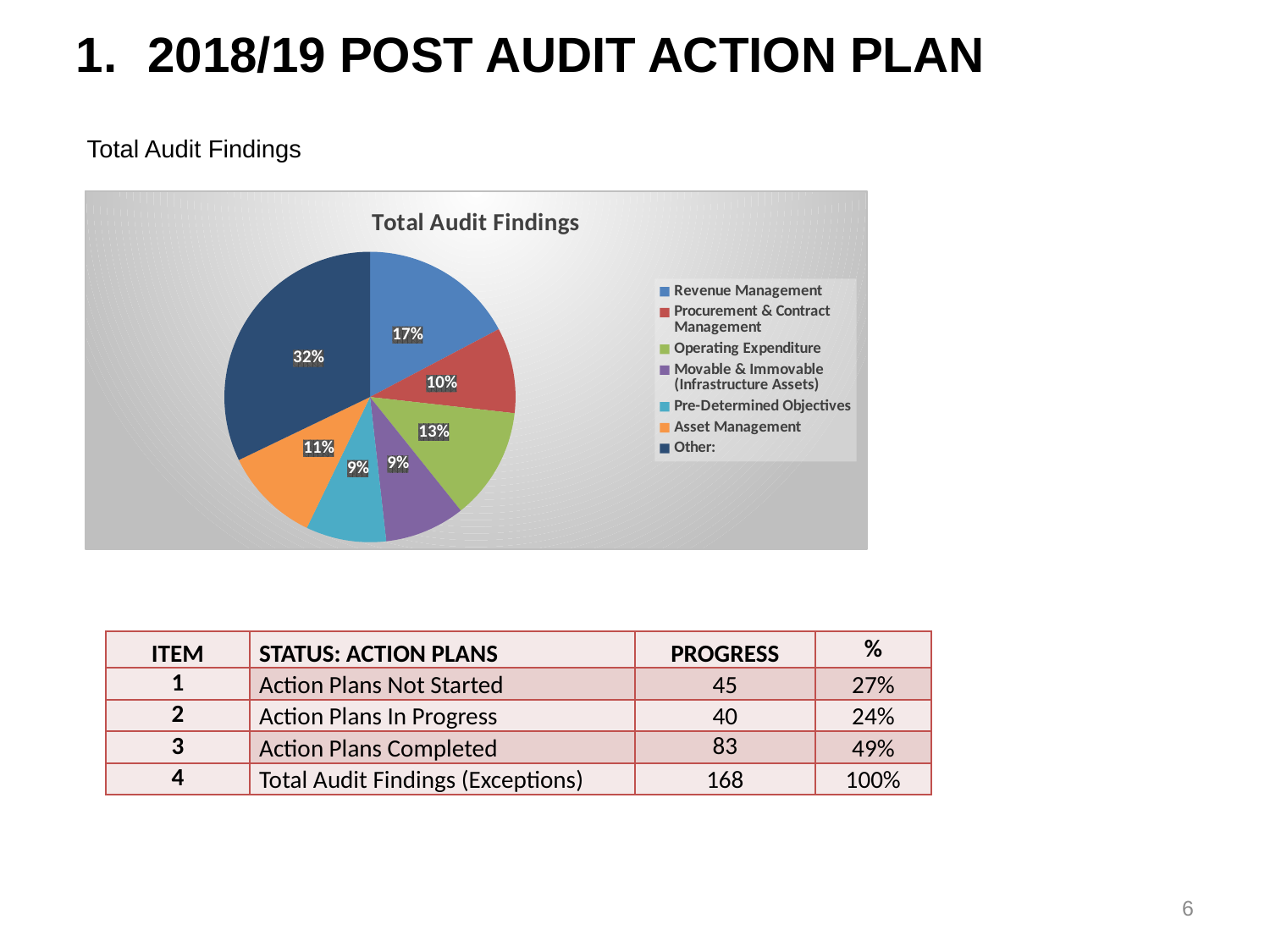
Which category has the largest share of total audit findings? Other: What share of total audit findings is Revenue Management? 17% What share of total audit findings is Operating Expenditure? 13% What is the difference in percentage points between the Other slice and the Revenue Management slice? 15 What share of total audit findings is labelled Other? 32% How many slices does the pie chart have? 7 What type of chart is shown on the slide? pie chart What is the title of the chart? Total Audit Findings Which is larger, the share for Operating Expenditure or the share for Asset Management? Operating Expenditure How many categories does the legend of the pie chart list? 7